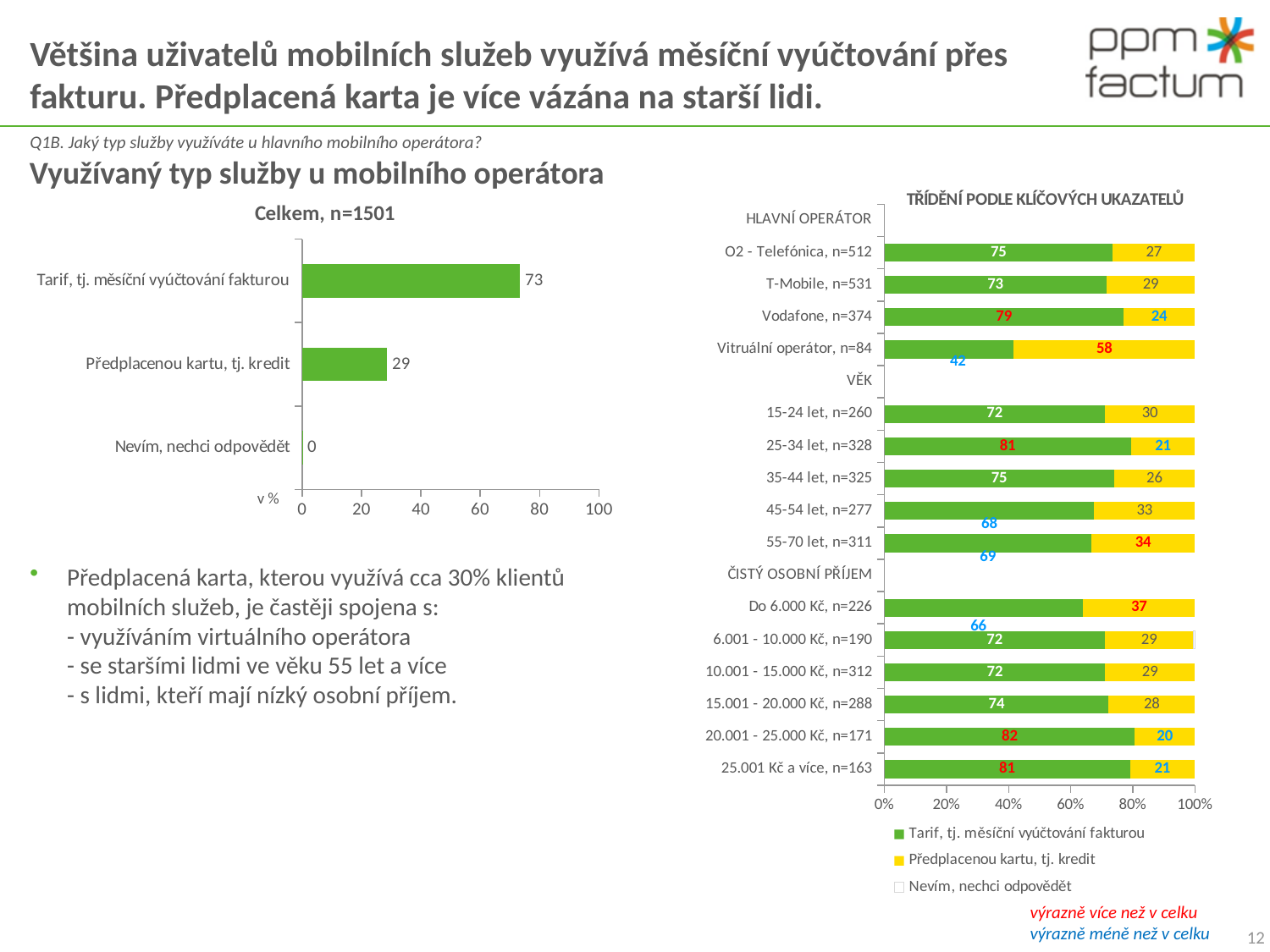
In the "TŘÍDĚNÍ PODLE KLÍČOVÝCH UKAZATELŮ" chart, is the "Předplacenou kartu, tj. kredit" value larger for "55-70 let, n=311" or for "25-34 let, n=328"? 55-70 let, n=311 In the "Celkem, n=1501" chart, which category has the highest value? Tarif, tj. měsíční vyúčtování fakturou In the "Celkem, n=1501" chart, what is the value for "Předplacenou kartu, tj. kredit"? 29 In the "TŘÍDĚNÍ PODLE KLÍČOVÝCH UKAZATELŮ" chart, which age group has the highest value for "Tarif, tj. měsíční vyúčtování fakturou"? 25-34 let, n=328 In the "Celkem, n=1501" chart, how many categories are shown? 3 In the "Celkem, n=1501" chart, what is the value for "Tarif, tj. měsíční vyúčtování fakturou"? 73 How many series does the legend of the "TŘÍDĚNÍ PODLE KLÍČOVÝCH UKAZATELŮ" chart list? 3 In the "Celkem, n=1501" chart, what is the difference between the values for "Tarif, tj. měsíční vyúčtování fakturou" and "Předplacenou kartu, tj. kredit"? 44 What kind of chart is the "Celkem, n=1501" chart? bar chart In the "TŘÍDĚNÍ PODLE KLÍČOVÝCH UKAZATELŮ" chart, what is the value of "Předplacenou kartu, tj. kredit" for "Vitruální operátor, n=84"? 58 In the "TŘÍDĚNÍ PODLE KLÍČOVÝCH UKAZATELŮ" chart, what is the value of "Tarif, tj. měsíční vyúčtování fakturou" for "20.001 - 25.000 Kč, n=171"? 82 In the "TŘÍDĚNÍ PODLE KLÍČOVÝCH UKAZATELŮ" chart, what is the value of "Tarif, tj. měsíční vyúčtování fakturou" for "Vodafone, n=374"? 79